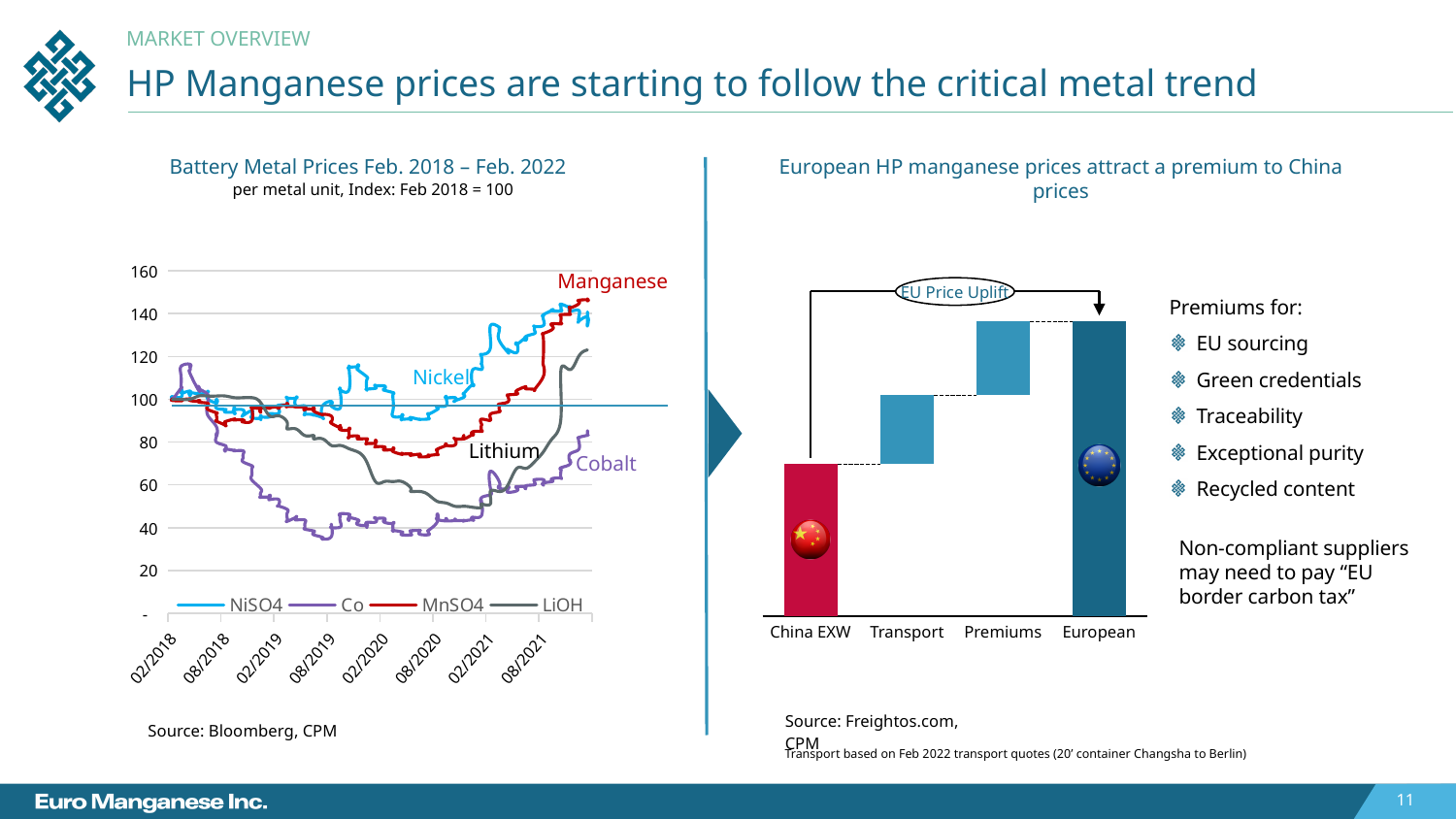
In the 'Battery Metal Prices Feb. 2018 – Feb. 2022' chart, does the Cobalt index rise or fall between 02/2018 and 02/2020? Fall In the 'Battery Metal Prices Feb. 2018 – Feb. 2022' chart, is the Cobalt index value at the end of the period greater or less than 100? less What kind of chart is the 'European HP manganese prices attract a premium to China prices' chart? Bar chart How many categories are shown on the x axis of the 'European HP manganese prices attract a premium to China prices' chart? 4 In the 'European HP manganese prices attract a premium to China prices' chart, which bar is taller: China EXW or European? European In the 'Battery Metal Prices Feb. 2018 – Feb. 2022' chart, what are the four legend entries? NiSO4, Co, MnSO4, LiOH In the 'Battery Metal Prices Feb. 2018 – Feb. 2022' chart, does the Manganese index rise or fall between 08/2020 and 02/2022? Rise How many series does the legend of the 'Battery Metal Prices Feb. 2018 – Feb. 2022' chart list? 4 What kind of chart is the 'Battery Metal Prices Feb. 2018 – Feb. 2022' chart? Line chart In the 'Battery Metal Prices Feb. 2018 – Feb. 2022' chart, which metal has the lowest index value at the end of the period (Feb 2022)? Cobalt In the 'Battery Metal Prices Feb. 2018 – Feb. 2022' chart, is the Manganese index value at the end of the period greater or less than 120? greater In the 'Battery Metal Prices Feb. 2018 – Feb. 2022' chart, which metal has the lowest index value around 08/2019? Cobalt